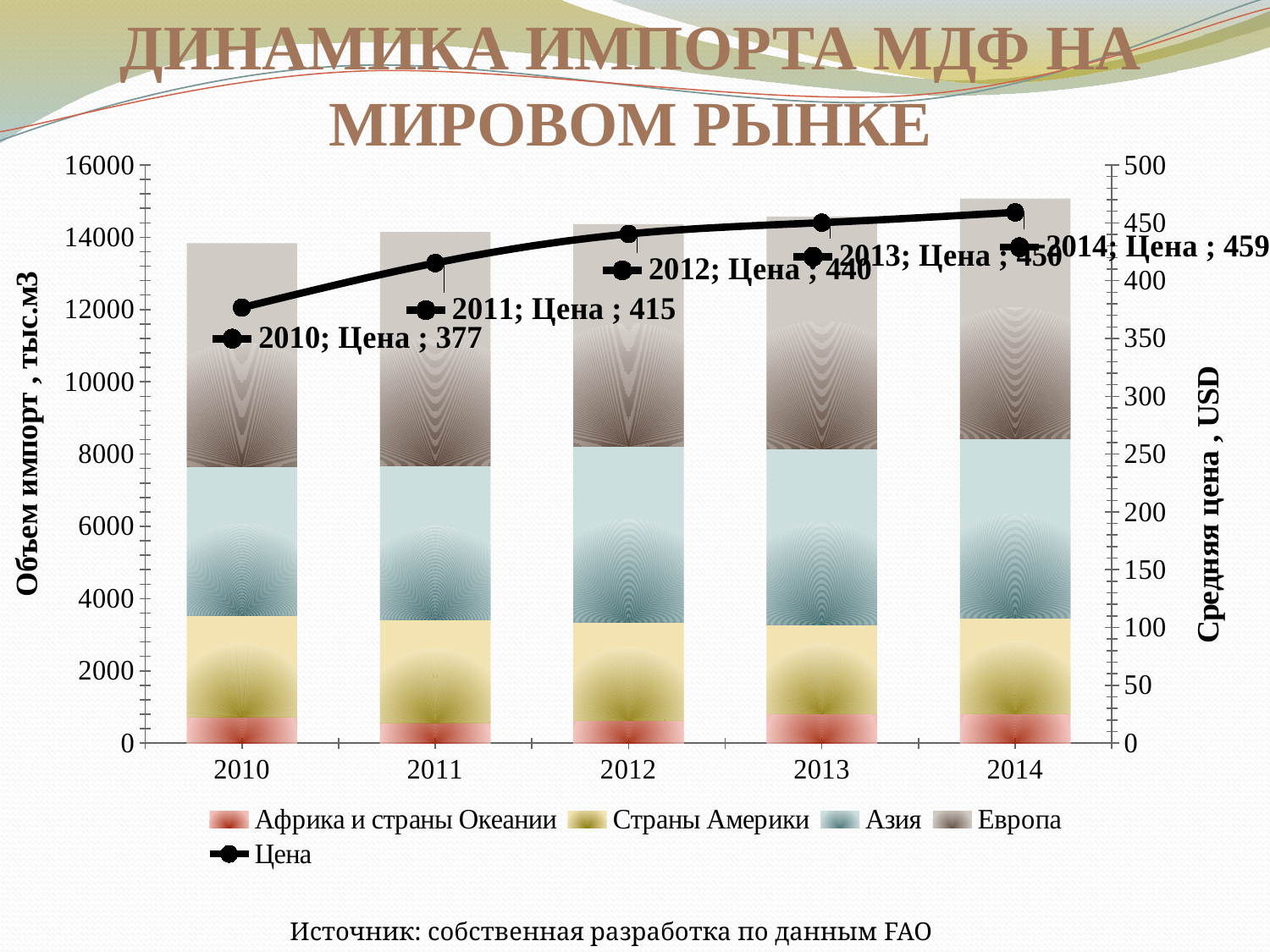
By how much did Цена increase from 2010 to 2014? 82 Is the total import volume (top of the stacked bar) for 2014 greater or less than 14000? greater Which year has the highest Цена value? 2014 What is the value of Цена for 2014? 459 What is the value of Цена for 2010? 377 How many series does the legend list? 5 What is the value of Цена for 2011? 415 Does the Цена line rise or fall from 2010 to 2014? rises What is the label of the right-hand vertical axis? Средняя цена , USD Which year has the lowest Цена value? 2010 How many years are shown on the x axis? 5 What is the value of Цена for 2012? 440